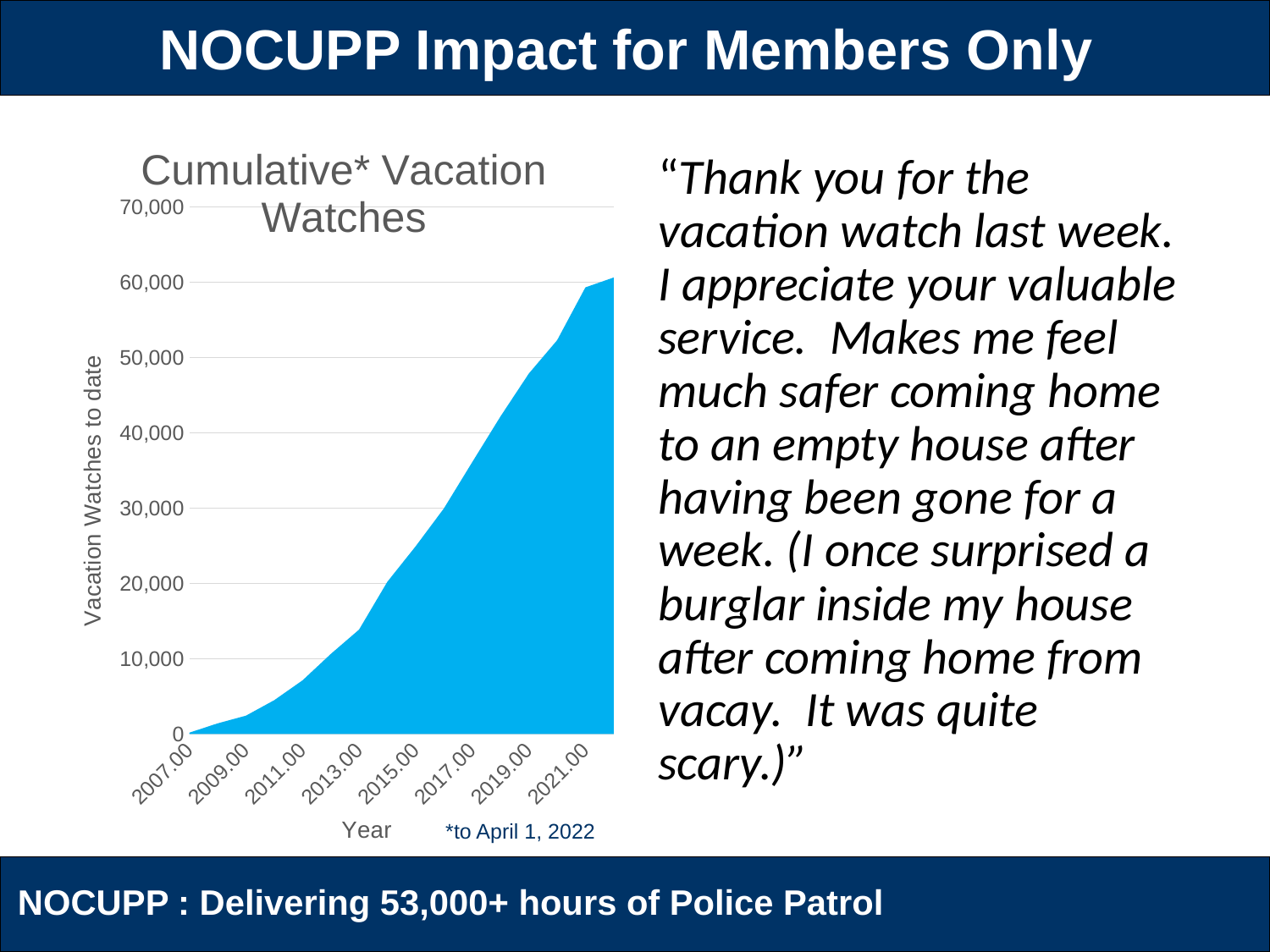
What type of chart is shown on the slide? area chart What is the label on the vertical axis of the chart? Vacation Watches to date Is the value for 2013.00 greater or less than 20,000? less How many year labels are shown on the x axis? 8 Do the cumulative vacation watches rise or fall from 2007 to 2021? rise Is the value for 2011.00 greater or less than 10,000? less Which is larger, the value for 2015.00 or the value for 2019.00? 2019.00 Which year shown on the x axis has the lowest cumulative vacation watches? 2007.00 Is the value for 2019.00 greater or less than 50,000? less What is the title of the chart? Cumulative* Vacation Watches